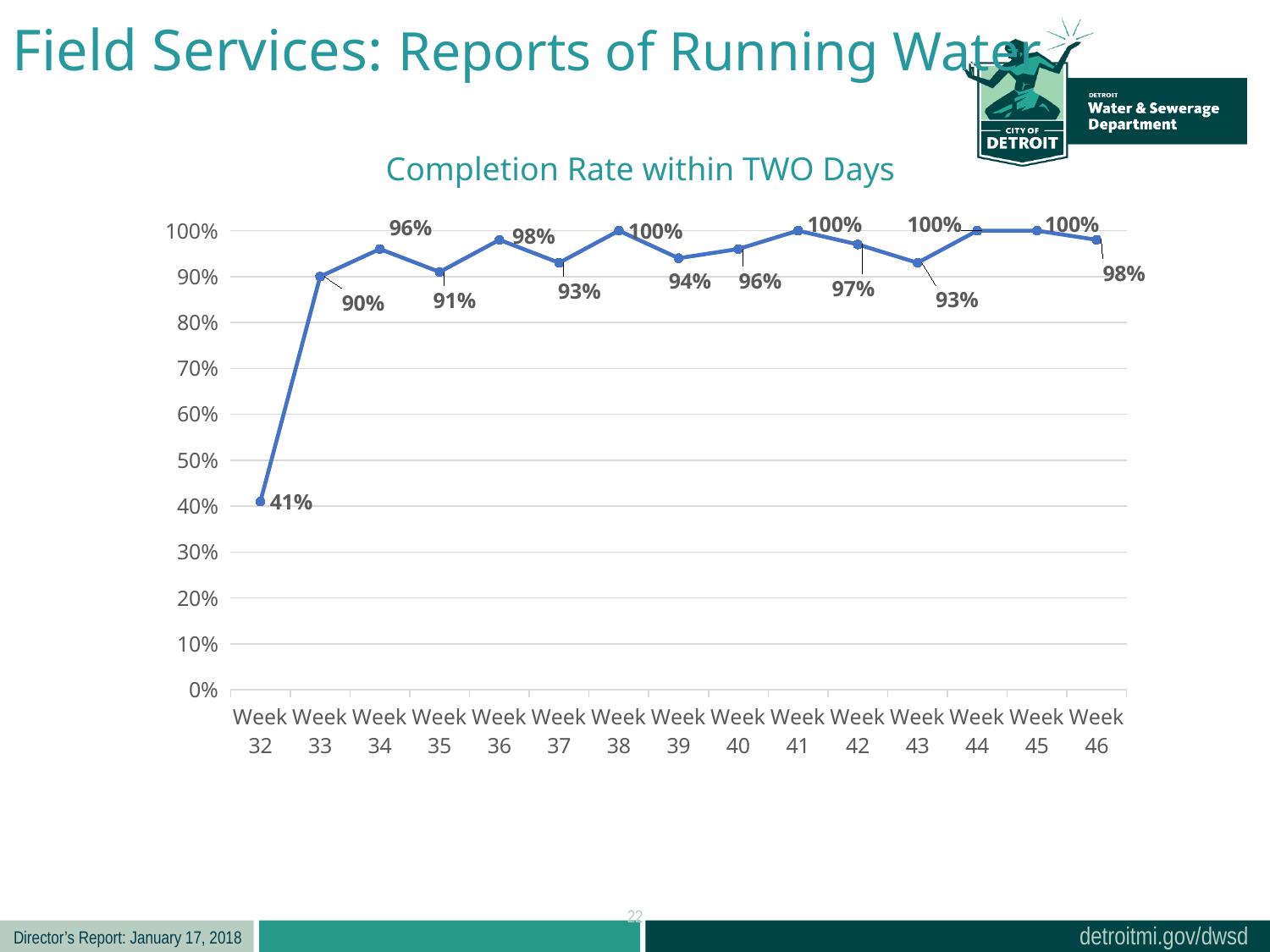
What is the completion rate within two days for Week 32? 41% What is the completion rate within two days for Week 36? 98% Which week has the lowest completion rate within two days? Week 32 What is the completion rate within two days for Week 46? 98% What is the completion rate within two days for Week 42? 97% What is the title of the chart? Completion Rate within TWO Days What is the highest completion rate shown on the chart? 100% What is the difference in completion rate between Week 33 and Week 32? 49% Which week has a higher completion rate, Week 34 or Week 35? Week 34 What is the difference in completion rate between Week 38 and Week 37? 7% What type of chart is shown on the slide? Line chart How many weeks are plotted on the chart? 15